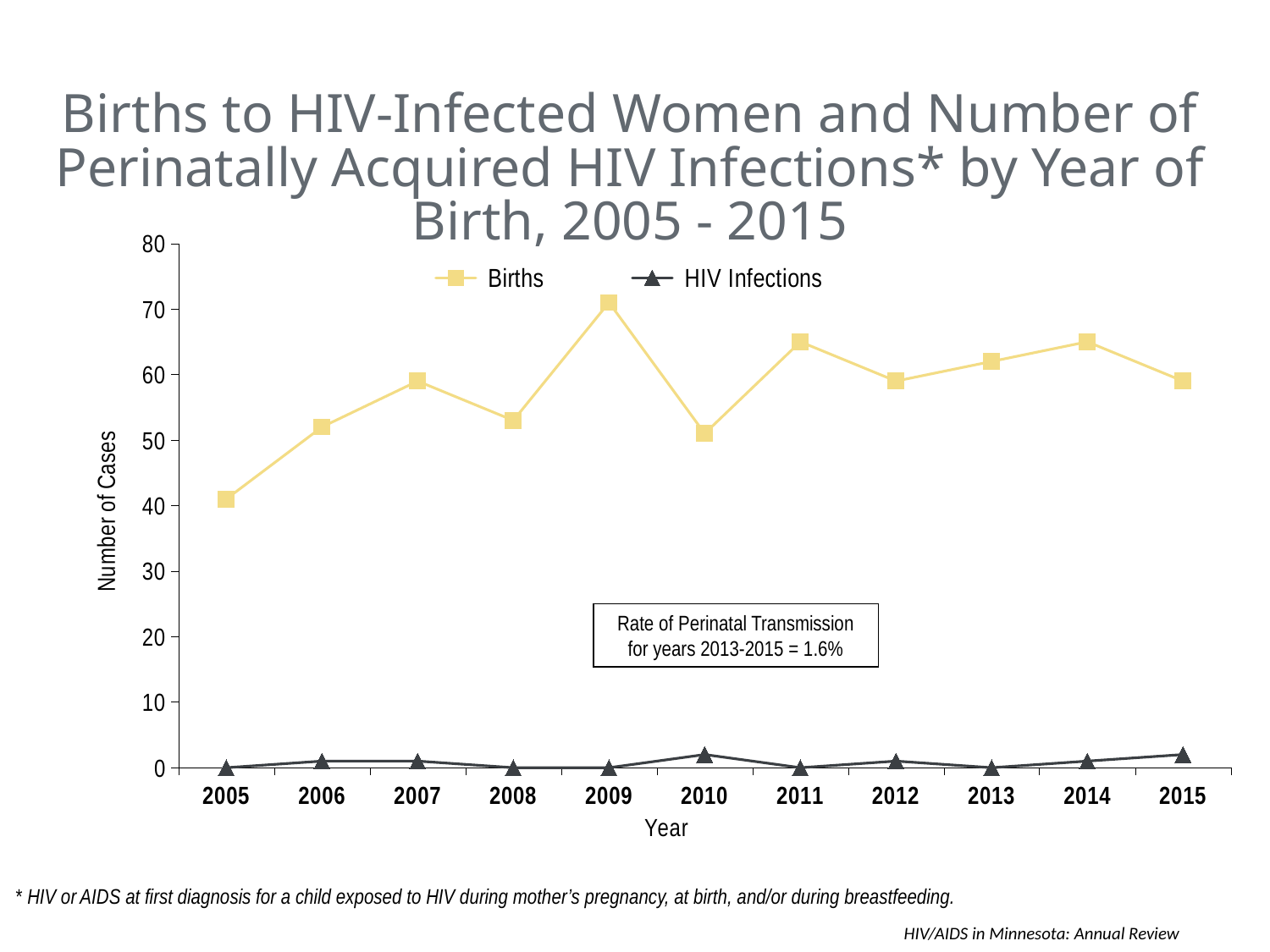
Is the value for Births in 2014 greater or less than 60? greater Is the value for Births in 2010 greater or less than 60? less What is the label on the y axis? Number of Cases Is the value for Births in 2005 greater or less than 50? less Which is larger, the number of Births in 2006 or in 2007? 2007 Do the Births values rise or fall from 2005 to 2007? rise In which year is the number of Births lowest? 2005 How many series does the legend list? 2 Which is larger, the number of Births in 2011 or in 2012? 2011 What kind of chart is shown on the slide? line chart In which year is the number of Births highest? 2009 How many years are plotted along the x axis? 11